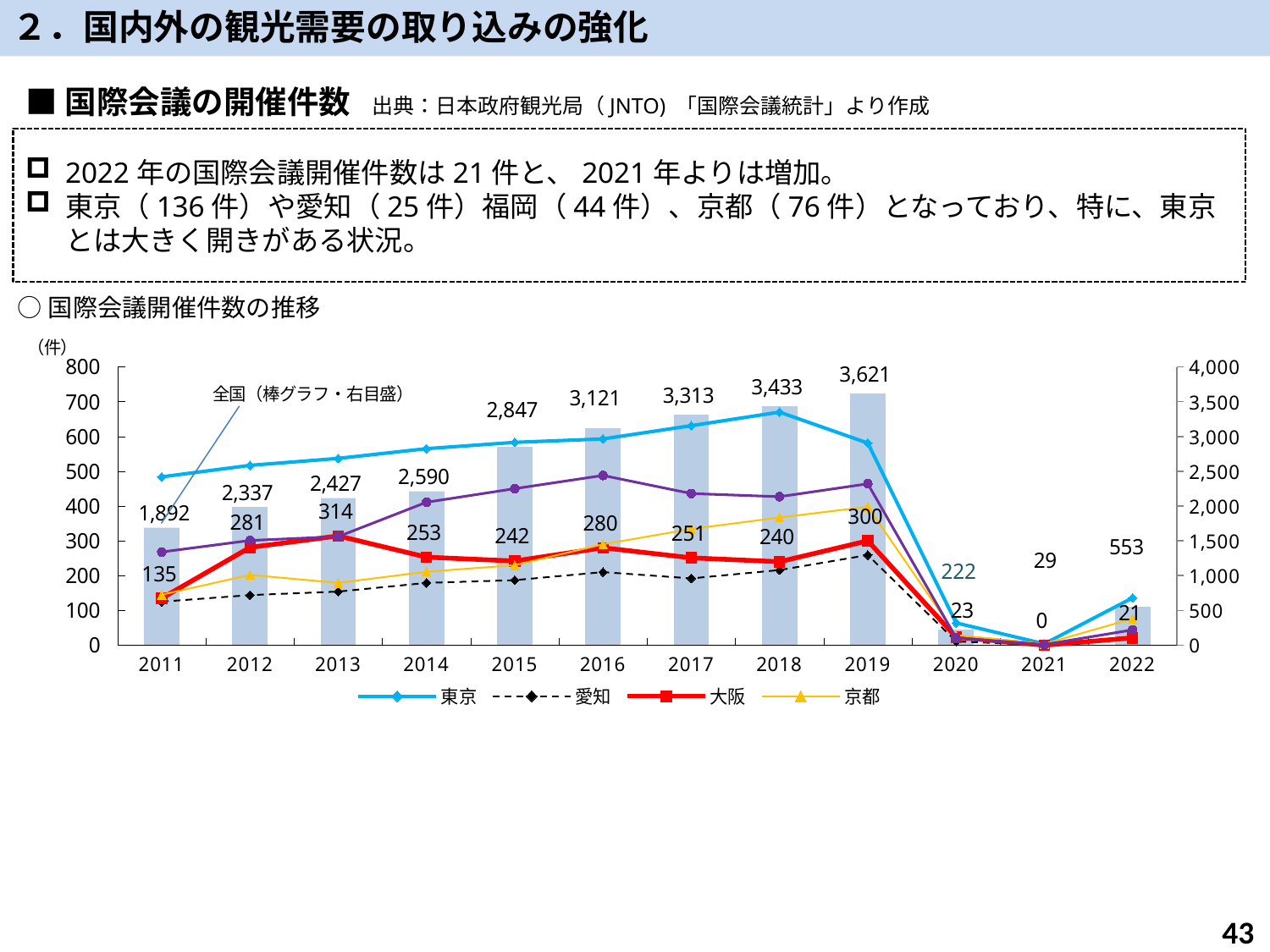
What is the value of the 全国 bar for 2019? 3,621 What is the difference between the 全国 values for 2019 and 2018? 188 What is the value for 大阪 in 2013? 314 In which year is the 全国 bar the lowest? 2021 What kind of chart is this? Combination bar and line chart How many years are shown on the x axis? 12 Which is larger for 大阪: the value in 2012 or the value in 2014? 2012 In which year is the 全国 bar the highest? 2019 Is the value for 東京 in 2018 greater or less than 600? greater What is the value for 大阪 in 2021? 0 Do the 全国 bar values rise or fall from 2011 to 2019? rise How many series does the legend list? 4